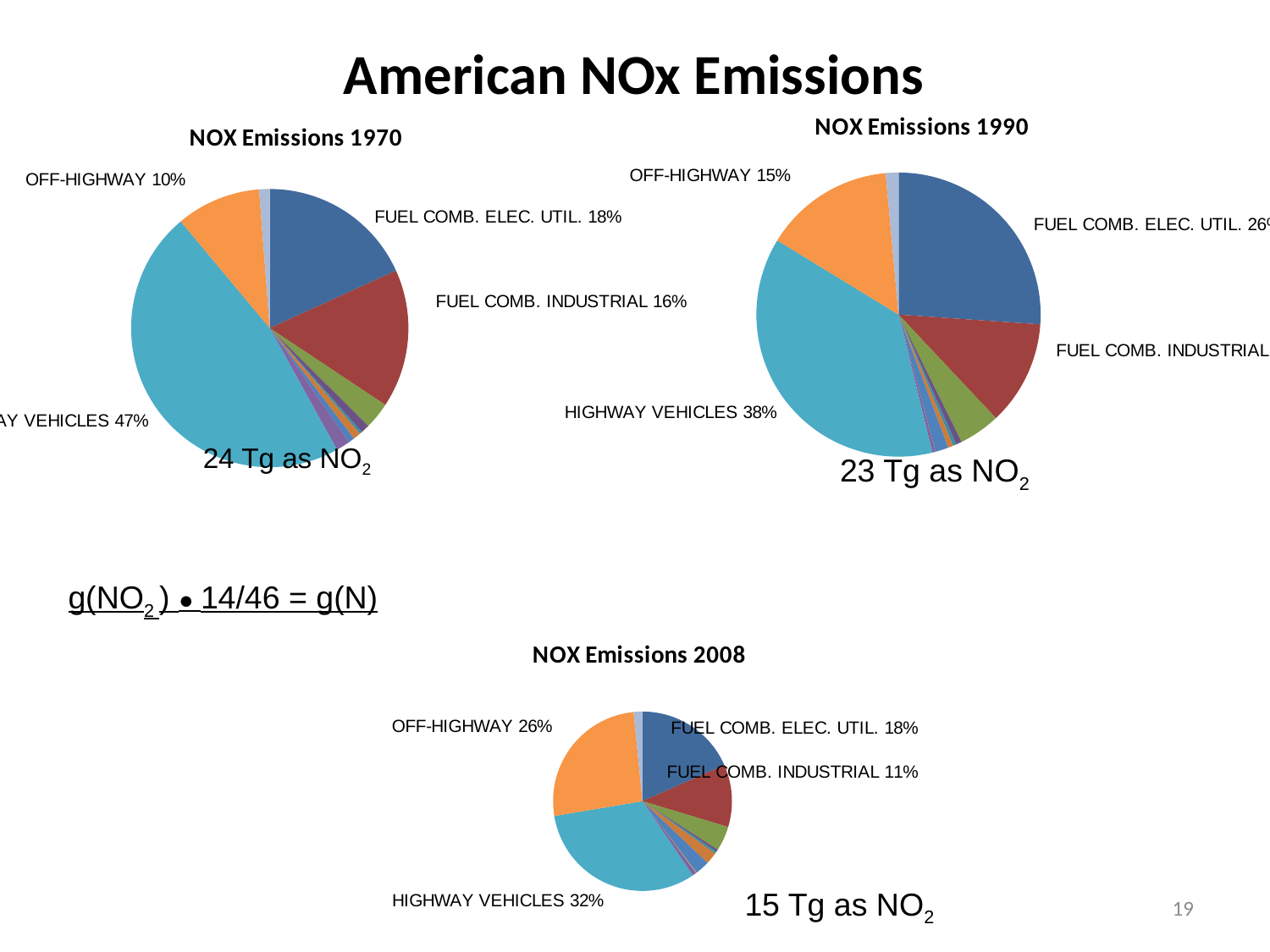
In the NOX Emissions 2008 chart, which labelled category has the largest share? HIGHWAY VEHICLES In the NOX Emissions 2008 chart, how many percentage points larger is HIGHWAY VEHICLES than OFF-HIGHWAY? 6 In the NOX Emissions 1990 chart, what share is HIGHWAY VEHICLES? 38% In the NOX Emissions 2008 chart, what share is HIGHWAY VEHICLES? 32% In the NOX Emissions 1970 chart, what share is OFF-HIGHWAY? 10% In the NOX Emissions 1990 chart, what share is OFF-HIGHWAY? 15% In the NOX Emissions 2008 chart, what share is FUEL COMB. INDUSTRIAL? 11% In the NOX Emissions 2008 chart, what share is OFF-HIGHWAY? 26% What type of chart is used for the NOX Emissions 1990 data? Pie chart In the NOX Emissions 1970 chart, which is larger, FUEL COMB. ELEC. UTIL. or FUEL COMB. INDUSTRIAL? FUEL COMB. ELEC. UTIL. In the NOX Emissions 1970 chart, what share is FUEL COMB. INDUSTRIAL? 16% In the NOX Emissions 1970 chart, what share is FUEL COMB. ELEC. UTIL.? 18%